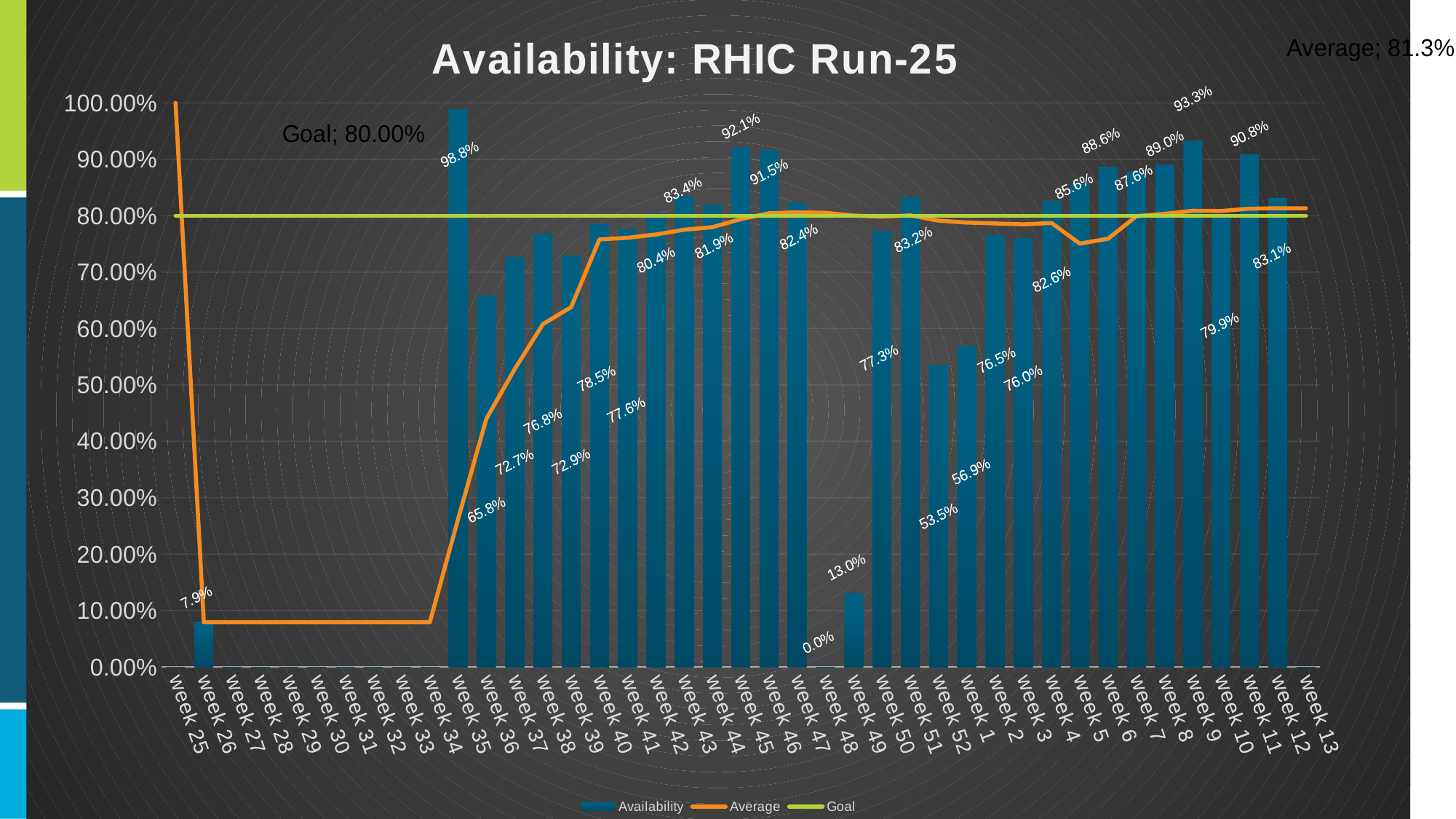
Which week has the highest availability? week 35 What is the availability value for week 35? 98.8% Is the availability for week 12 greater or less than 80.00%? greater What is the difference between the availability for week 44 and week 45? 10.2% Which has the higher availability, week 5 or week 6? week 6 What is the availability value for week 8? 89.0% How many series does the legend list? 3 What kind of chart is shown on the slide? combination bar and line chart What is the Average value shown on the chart? 81.3% What is the difference between the availability for week 35 and week 36? 33.0% What is the availability value for week 48? 0.0% What is the Goal value shown on the chart? 80.00%